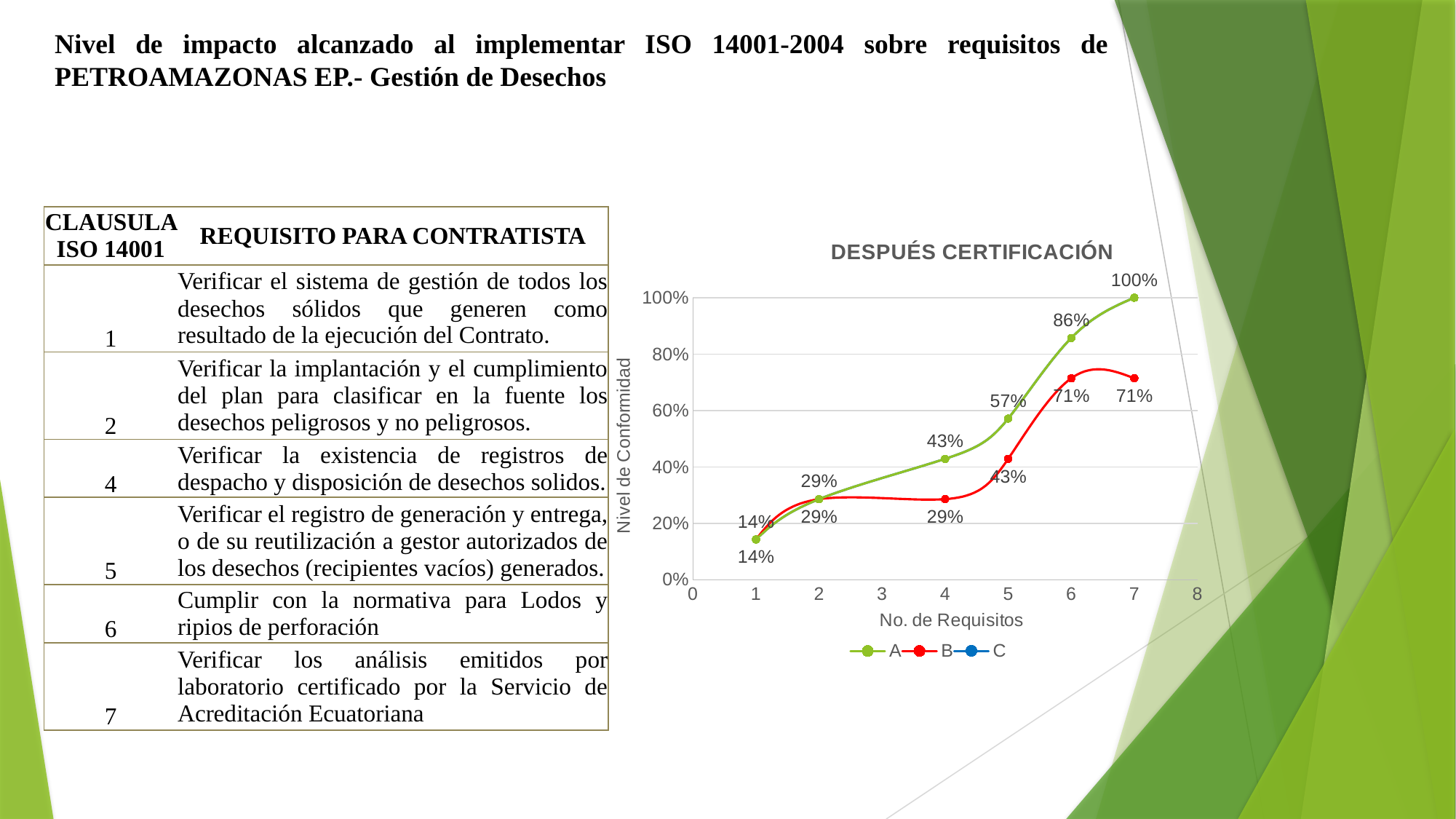
What is the lowest value shown for series B? 14% Does series A rise or fall as the number of requisitos increases? rises What is the value of series B at requisito 6? 71% What is the value of series A at requisito 5? 57% At requisito 4, which series has the higher value, A or B? A What is the value of series A at requisito 7? 100% What kind of chart is shown on the slide? line chart What is the difference between series A and series B at requisito 6? 15% How many series does the legend list? 3 At which requisito number does series A reach its highest value? 7 What is the title of the chart? DESPUÉS CERTIFICACIÓN What is the value of series B at requisito 4? 29%